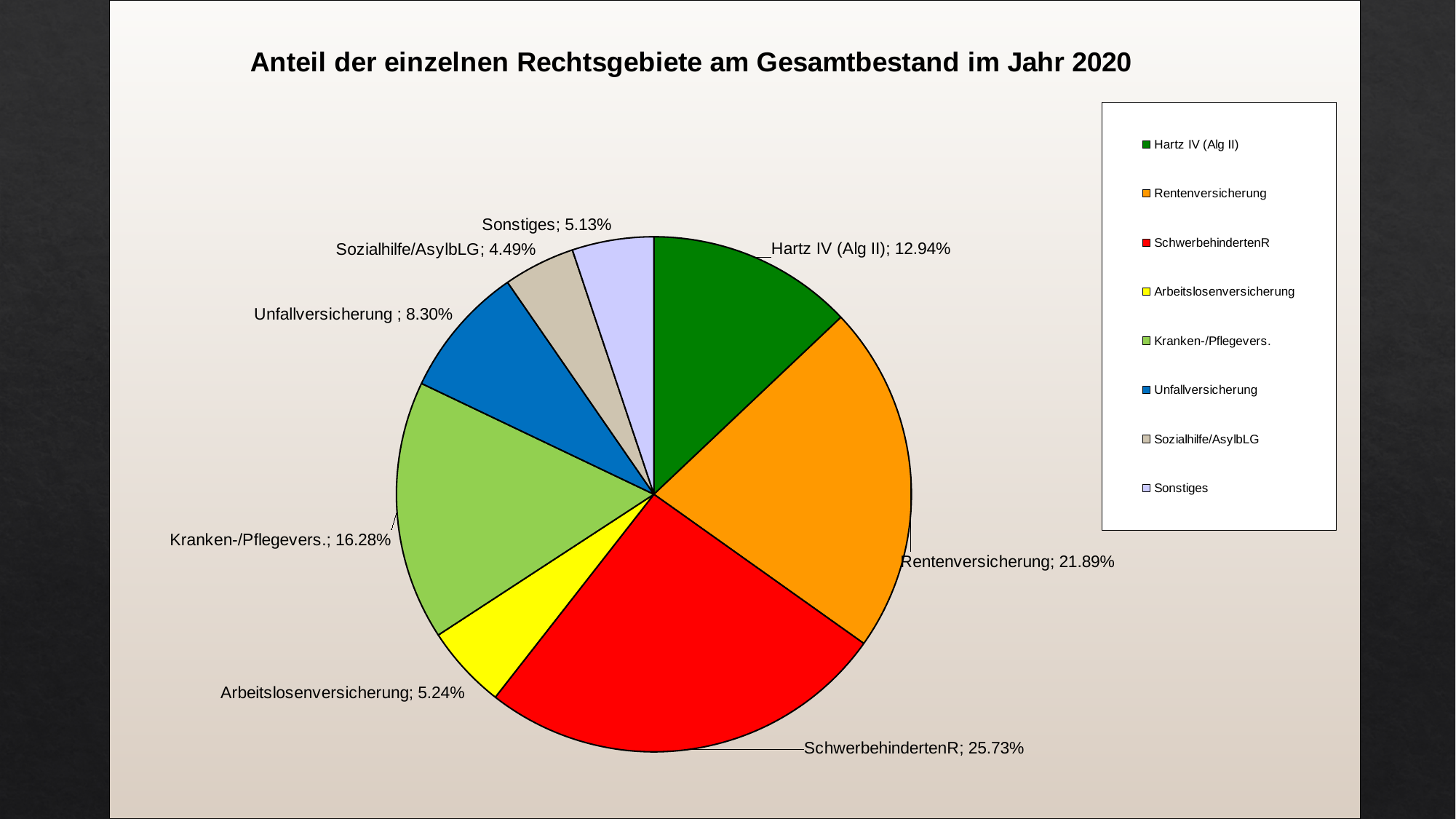
Which category has the smallest share of the pie? Sozialhilfe/AsylbLG How many categories does the pie chart have? 8 Which category has the largest share of the pie? SchwerbehindertenR What is the title of the chart? Anteil der einzelnen Rechtsgebiete am Gesamtbestand im Jahr 2020 What is the difference in percentage points between SchwerbehindertenR and Rentenversicherung? 3.84 What is the share for Kranken-/Pflegevers.? 16.28% What type of chart is shown on the slide? pie chart Which is larger, the share for Hartz IV (Alg II) or the share for Unfallversicherung? Hartz IV (Alg II) What is the share for Rentenversicherung? 21.89% What colour is the slice for Arbeitslosenversicherung? yellow What is the share for Unfallversicherung? 8.30% What is the share for SchwerbehindertenR? 25.73%